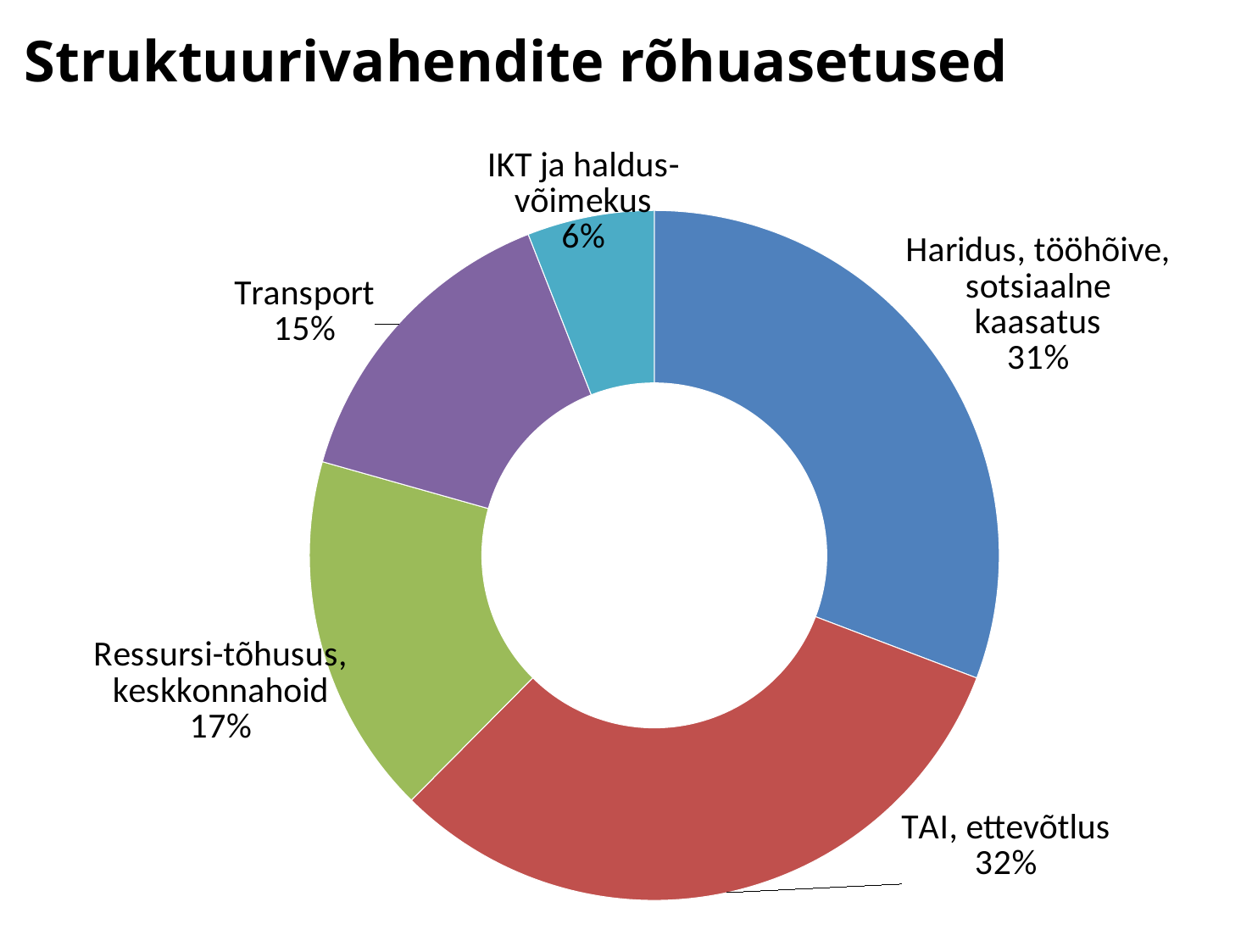
What percentage is shown for Ressursi-tõhusus, keskkonnahoid? 17% Which category has the smallest share of the chart? IKT ja haldusvõimekus What percentage is shown for Haridus, tööhõive, sotsiaalne kaasatus? 31% What share of the chart does TAI, ettevõtlus represent? 32% What kind of chart is shown on the slide? Doughnut (pie) chart What percentage is shown for Transport? 15% How many categories are shown in the chart? 5 Which category has the largest share of the chart? TAI, ettevõtlus What is the difference in percentage points between Ressursi-tõhusus, keskkonnahoid and Transport? 2 percentage points What percentage is shown for IKT ja haldusvõimekus? 6% What is the title of the slide? Struktuurivahendite rõhuasetused Which is larger: the share for Transport or the share for IKT ja haldusvõimekus? Transport